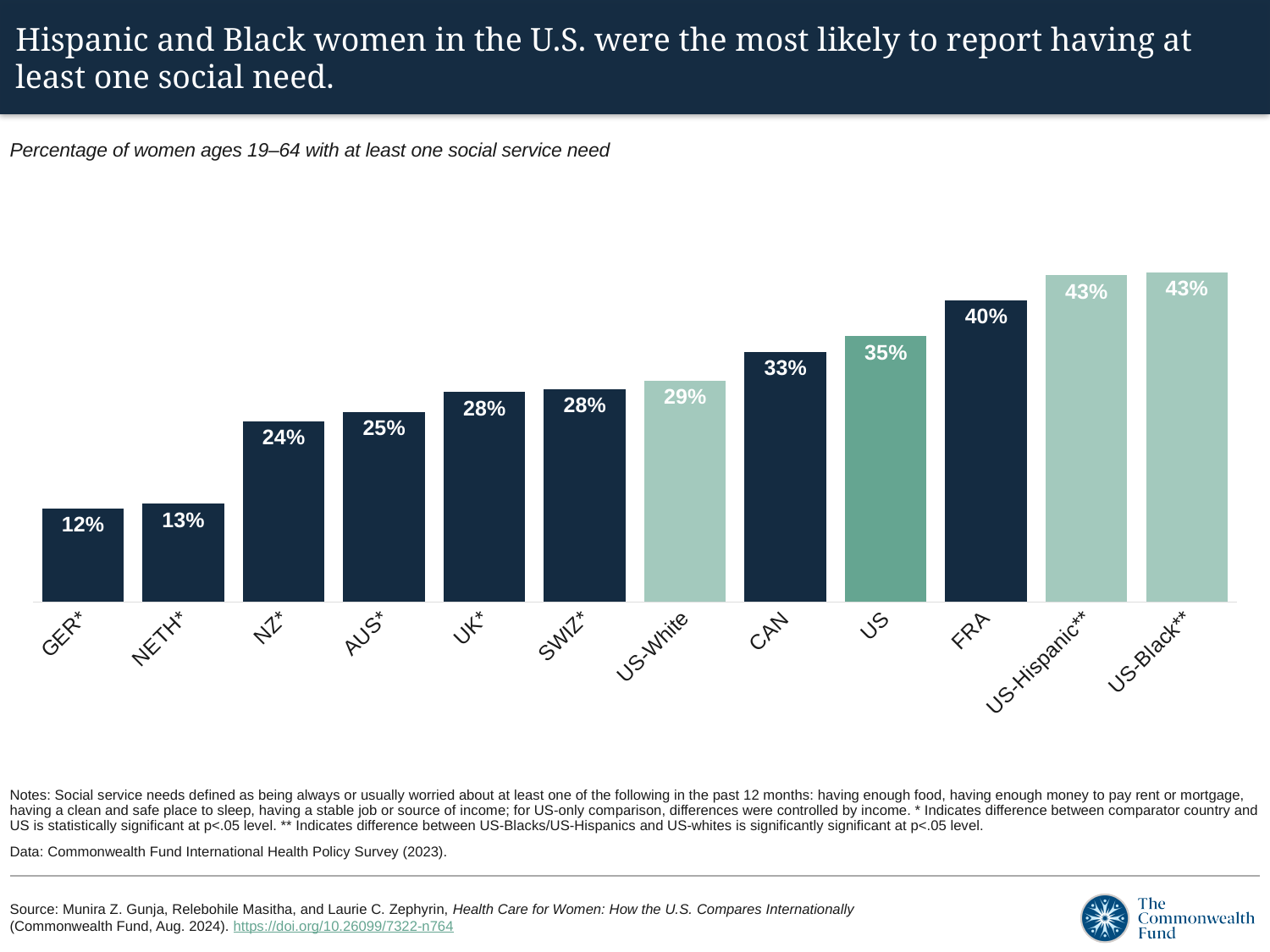
What is the subtitle describing what the chart measures? Percentage of women ages 19–64 with at least one social service need What is the difference between the values for US-Black** and US-White? 14% Which is larger, the value for NZ* or the value for AUS*? AUS* What is the difference between the values for FRA and US? 5% What is the value for GER*? 12% Which category has the lowest value? GER* What is the value for CAN? 33% How many categories are shown on the x axis? 12 What is the value for US-White? 29% Do the values generally rise or fall from left to right along the x axis? rise What is the value for FRA? 40% What kind of chart is shown on the slide? bar chart